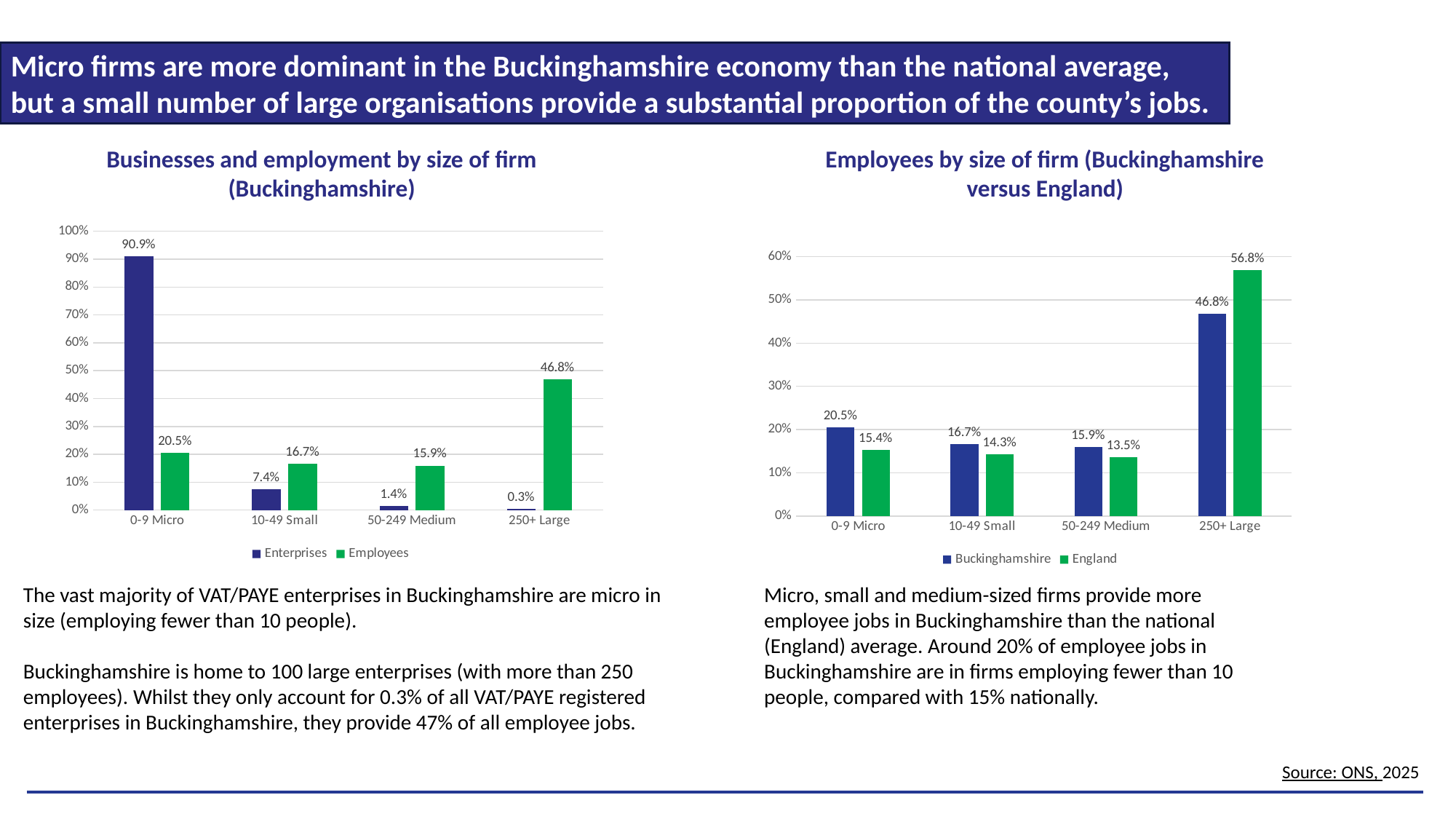
In the 'Employees by size of firm (Buckinghamshire versus England)' chart, which is larger for 50-249 Medium firms: Buckinghamshire or England? Buckinghamshire In the 'Employees by size of firm (Buckinghamshire versus England)' chart, what is the Buckinghamshire value for 0-9 Micro firms? 20.5% In the 'Employees by size of firm (Buckinghamshire versus England)' chart, what is the England value for 250+ Large firms? 56.8% In the 'Businesses and employment by size of firm (Buckinghamshire)' chart, how many series does the legend list? 2 In the 'Businesses and employment by size of firm (Buckinghamshire)' chart, what percentage of enterprises are 0-9 Micro? 90.9% In the 'Businesses and employment by size of firm (Buckinghamshire)' chart, what is the difference between the Employees values for 10-49 Small and 50-249 Medium firms? 0.8% In the 'Employees by size of firm (Buckinghamshire versus England)' chart, which colour represents England in the legend? Green In the 'Businesses and employment by size of firm (Buckinghamshire)' chart, which size category has the lowest Enterprises value? 250+ Large In the 'Businesses and employment by size of firm (Buckinghamshire)' chart, what kind of chart is shown? Bar chart In the 'Employees by size of firm (Buckinghamshire versus England)' chart, what is the difference between the England and Buckinghamshire values for 250+ Large firms? 10.0% In the 'Employees by size of firm (Buckinghamshire versus England)' chart, how many size categories are shown on the x axis? 4 In the 'Businesses and employment by size of firm (Buckinghamshire)' chart, what is the Employees value for 250+ Large firms? 46.8%